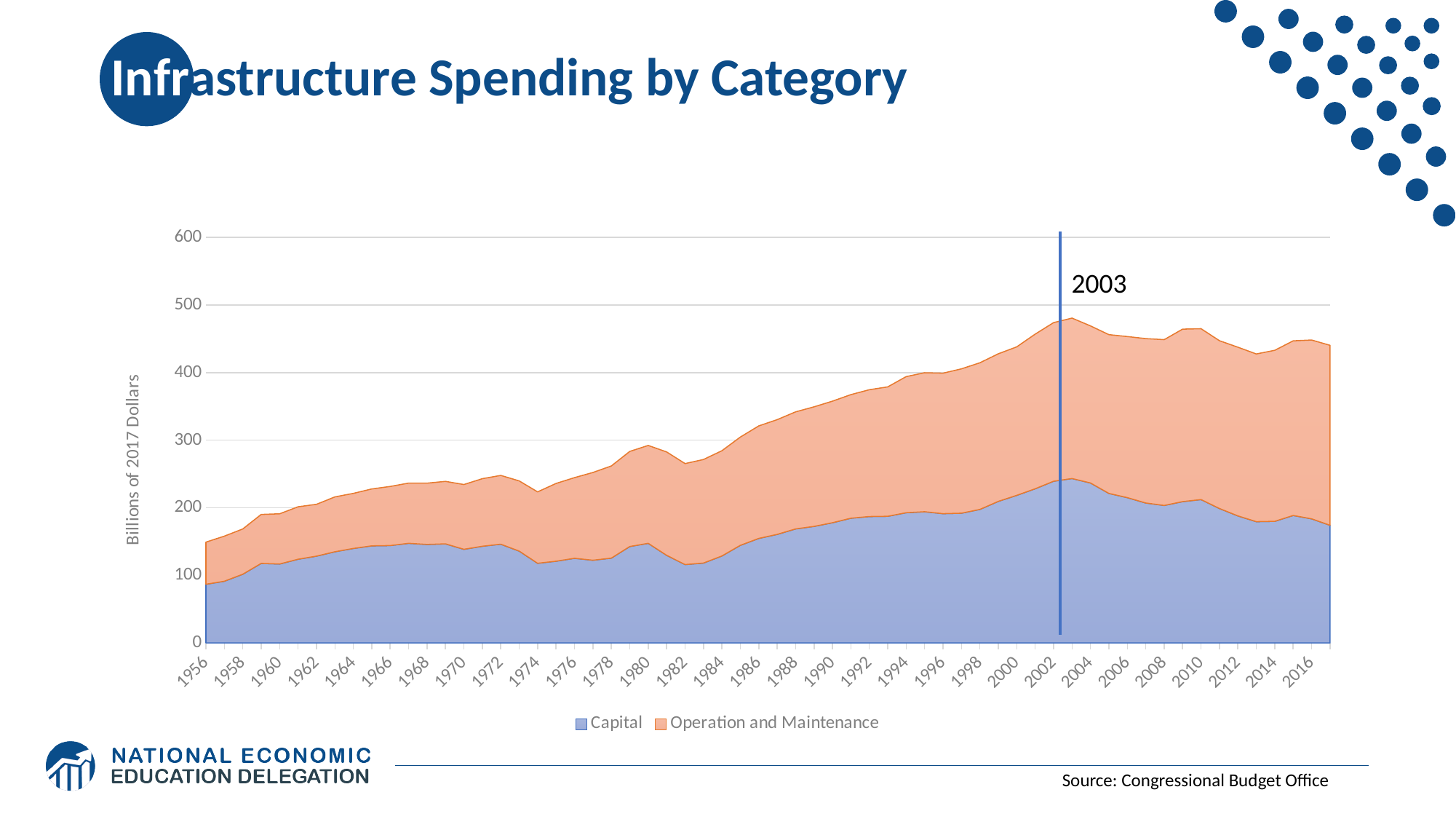
Is the total spending in 1956 greater or less than 200? less What is the label on the vertical axis? Billions of 2017 Dollars Which year is marked by the vertical line on the chart? 2003 What kind of chart is shown on the slide? Stacked area chart What are the two series named in the legend? Capital; Operation and Maintenance Is the Capital value in 1956 greater or less than 100? less Is the Capital value in 2003 greater or less than 200? greater How many series does the legend list? 2 Does total infrastructure spending generally rise or fall from 1956 to 2003? rise In 2016, which series is larger: Capital or Operation and Maintenance? Operation and Maintenance